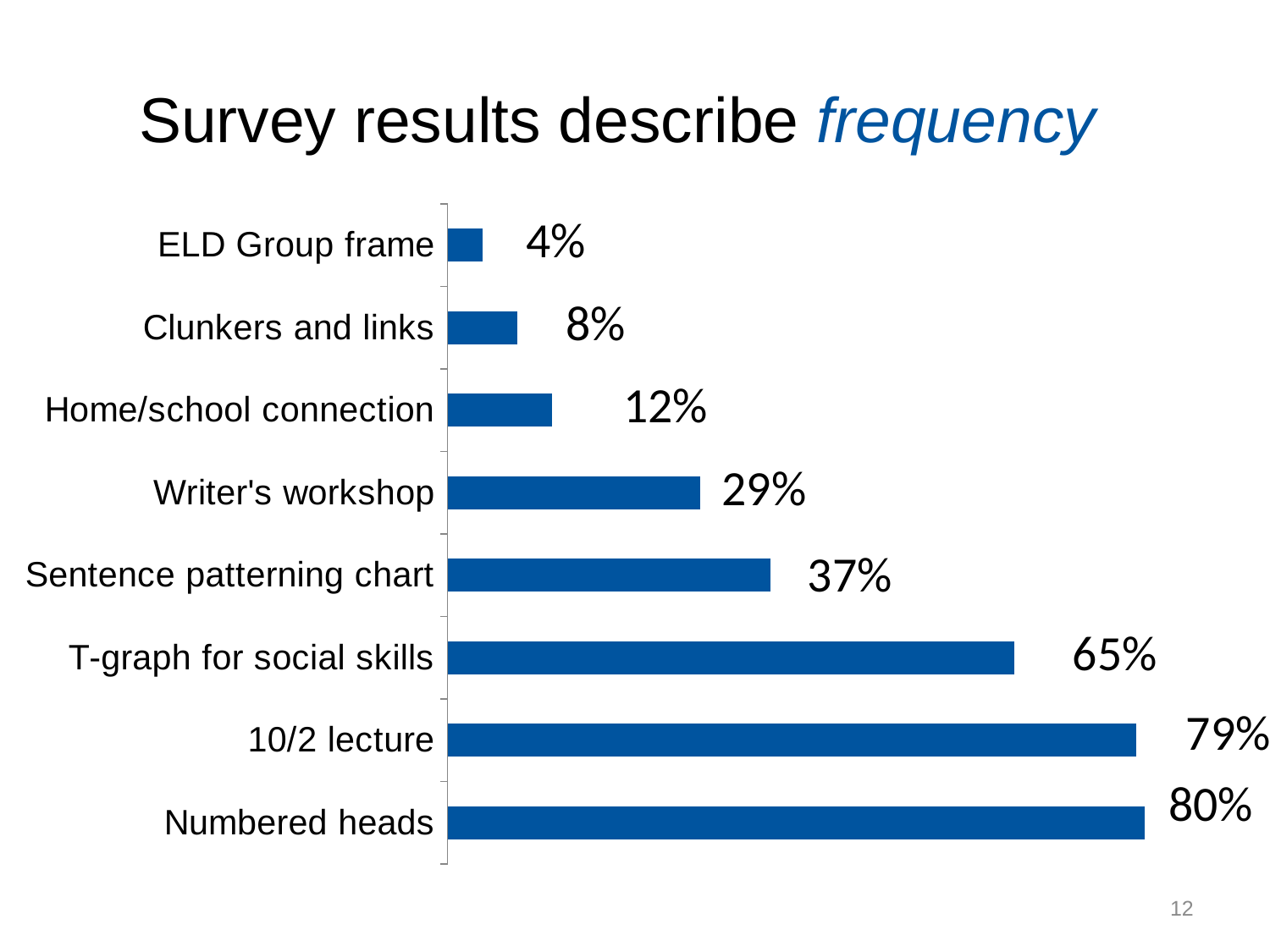
Which is larger, the value for T-graph for social skills or the value for Sentence patterning chart? T-graph for social skills What kind of chart is shown on the slide? Bar chart What is the value for Numbered heads? 80% What is the value for T-graph for social skills? 65% What is the difference between the values for 10/2 lecture and Sentence patterning chart? 42% Which category has the lowest value? ELD Group frame Which category has the highest value? Numbered heads What is the title of the slide containing the chart? Survey results describe frequency How many categories are shown in the chart? 8 What is the value for Home/school connection? 12% What is the value for Writer's workshop? 29% What is the difference between the values for Clunkers and links and ELD Group frame? 4%